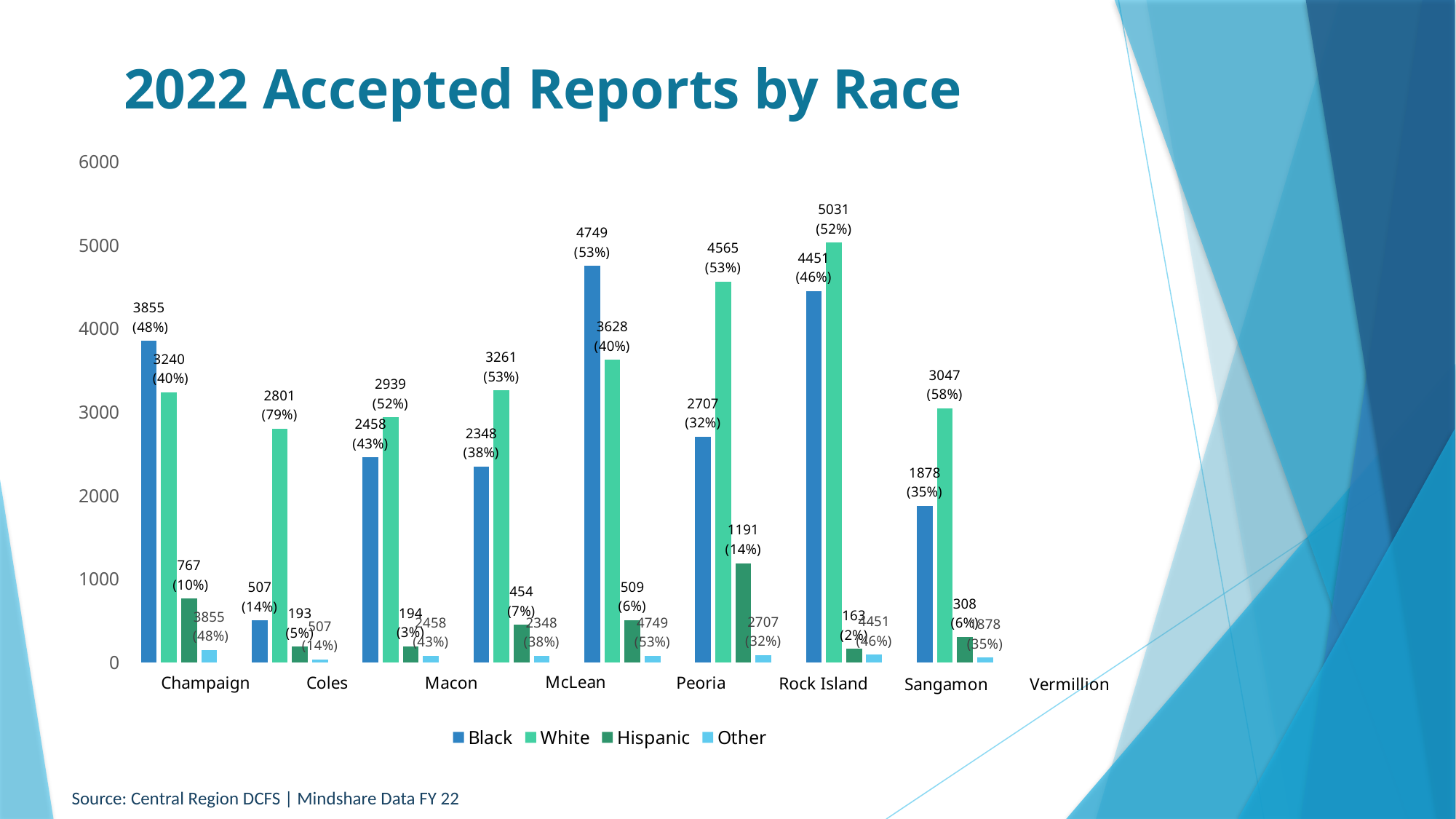
What is the value for White in Coles? 2801 What is the difference between the White and Black values in Sangamon? 1169 What kind of chart is shown on the slide? Bar chart In Peoria, which is larger, the Black value or the White value? White What percentage is shown for White in Coles? 79% Which county has the lowest value for Hispanic? Rock Island Is the value for Other in Champaign greater or less than 1000? less Which county has the highest value for Black? McLean How many counties are shown on the x axis? 8 What is the value for Hispanic in Rock Island? 163 How many series does the legend list? 4 Which county has the highest value for White? Rock Island